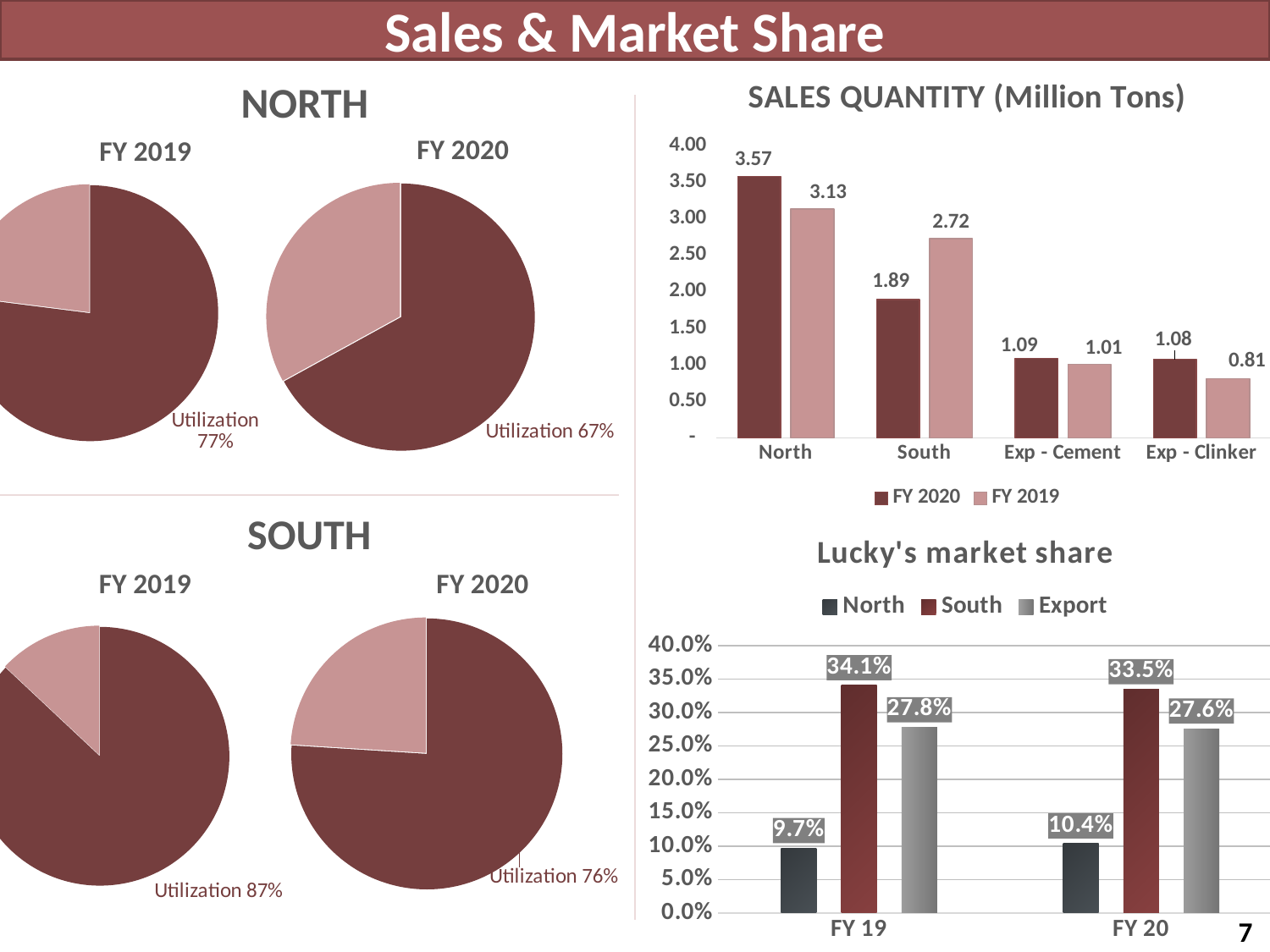
What kind of chart is the Lucky's market share chart? bar chart In the Lucky's market share chart, which series has the highest value in FY 19? South How many series does the legend of the SALES QUANTITY (Million Tons) chart list? 2 In the SALES QUANTITY (Million Tons) chart, what is the difference between the FY 2020 and FY 2019 values for North? 0.44 In the SALES QUANTITY (Million Tons) chart, is the FY 2020 value for South larger or smaller than its FY 2019 value? smaller In the SALES QUANTITY (Million Tons) chart, what is the FY 2020 value for North? 3.57 In the SALES QUANTITY (Million Tons) chart, what is the FY 2019 value for South? 2.72 What utilization percentage is shown on the SOUTH FY 2019 pie chart? 87% How many categories are shown on the x axis of the SALES QUANTITY (Million Tons) chart? 4 In the Lucky's market share chart, what is the North value for FY 19? 9.7% In the SALES QUANTITY (Million Tons) chart, which category has the lowest FY 2019 value? Exp - Clinker In the Lucky's market share chart, what is the South value for FY 20? 33.5%